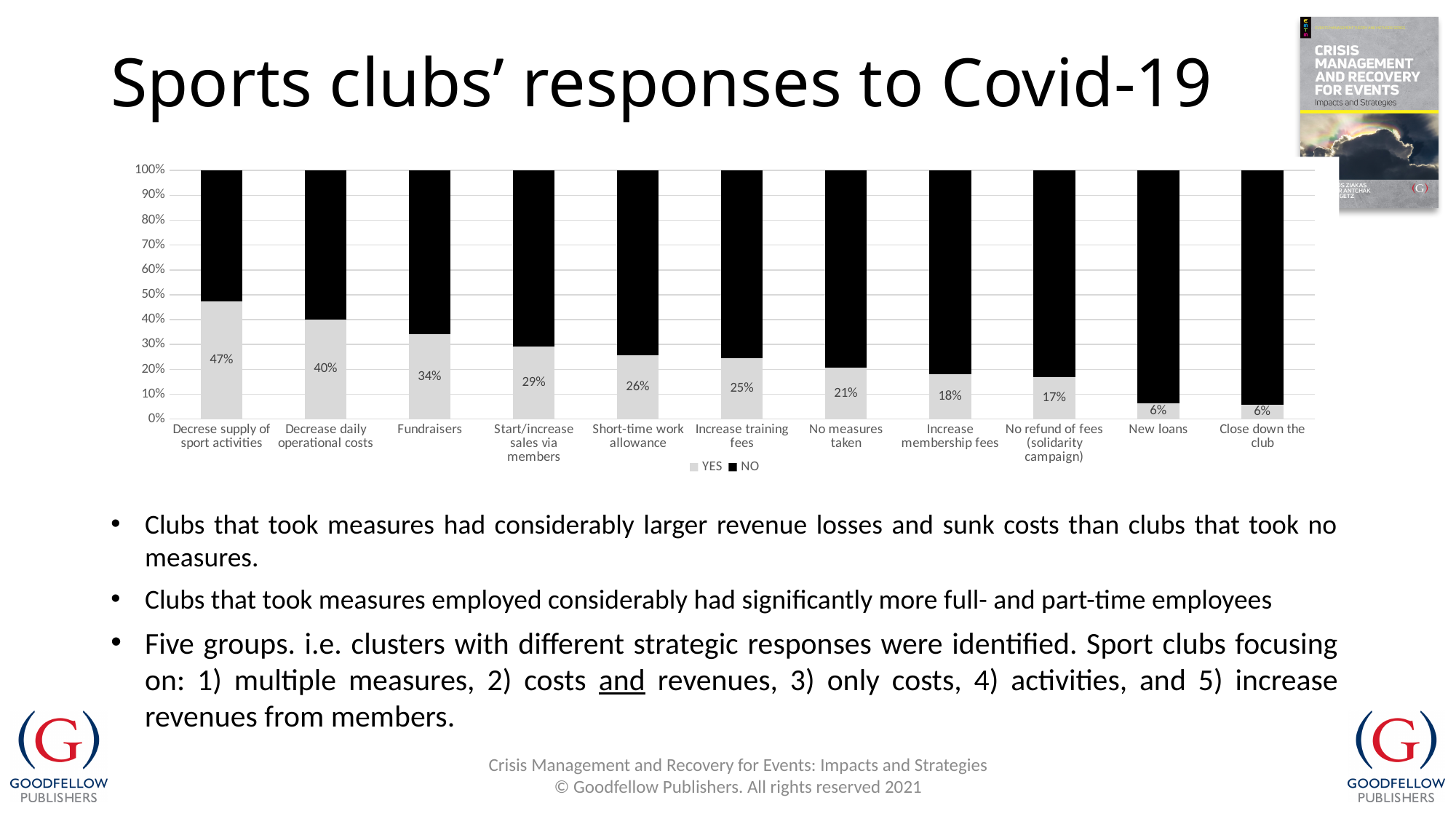
Which has a larger YES value: "Short-time work allowance" or "Increase training fees"? Short-time work allowance Which colour represents the NO series in the chart? Black Which category has the highest YES percentage? Decrese supply of sport activities What is the YES value for "No refund of fees (solidarity campaign)"? 17% Is the YES value for "Start/increase sales via members" greater or less than 30%? less What kind of chart is shown on the slide? Stacked bar chart What is the YES value for "Fundraisers"? 34% How many categories are shown on the x axis of the chart? 11 What percentage of clubs answered YES to "Decrese supply of sport activities"? 47% What is the YES value for "No measures taken"? 21% How many series does the chart legend list? 2 What is the difference between the YES values for "Decrease daily operational costs" and "Increase membership fees"? 22%